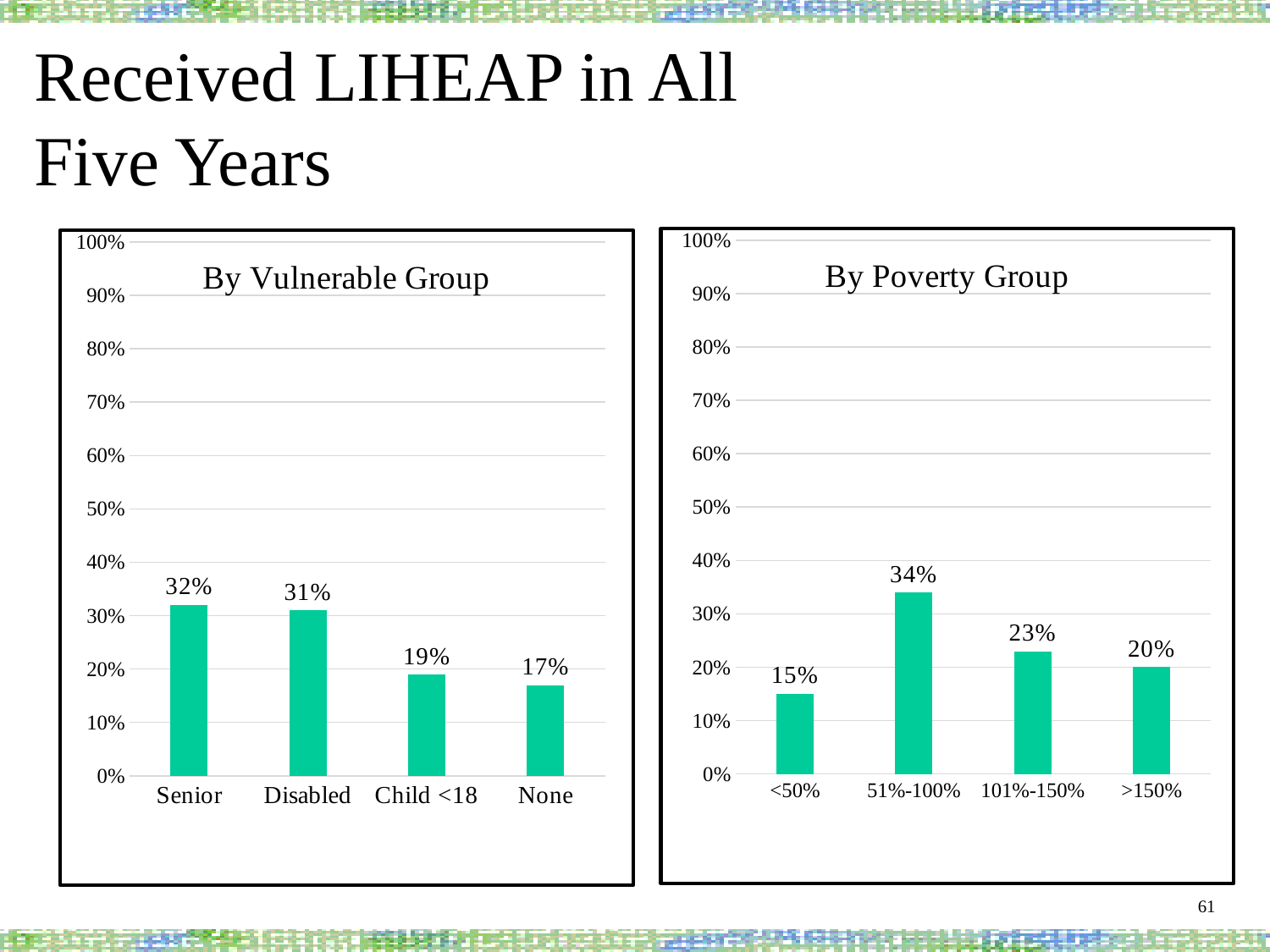
In the 'By Poverty Group' chart, what is the value for 51%-100%? 34% In the 'By Poverty Group' chart, what is the difference between the 51%-100% and <50% values? 19% In the 'By Vulnerable Group' chart, what is the difference between the Disabled and None values? 14% What kind of chart is the 'By Poverty Group' chart? Bar chart In the 'By Poverty Group' chart, what is the value for <50%? 15% In the 'By Vulnerable Group' chart, which category has the lowest value? None In the 'By Vulnerable Group' chart, what is the value for Child <18? 19% In the 'By Vulnerable Group' chart, how many categories are shown? 4 In the 'By Vulnerable Group' chart, what is the value for Senior? 32% In the 'By Poverty Group' chart, which category has the highest value? 51%-100% In the 'By Poverty Group' chart, which is larger, the value for 101%-150% or the value for >150%? 101%-150% In the 'By Vulnerable Group' chart, do the values rise or fall from Senior to None? Fall